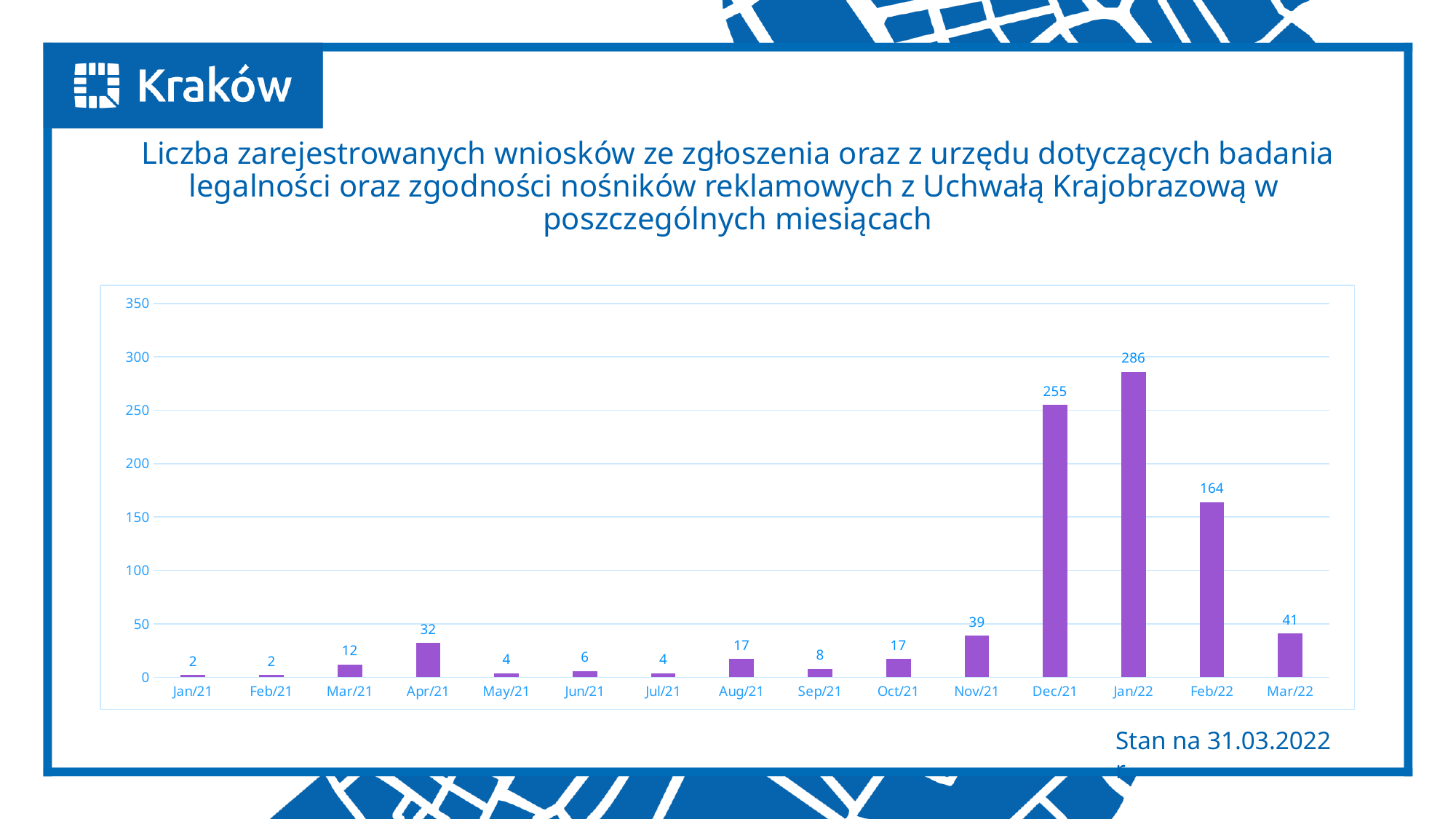
Which month has the highest value? Jan/22 What is the value for Sep/21? 8 How many months are shown on the x axis? 15 Is the value for Feb/22 greater or less than 150? greater Which is larger, the value for Nov/21 or the value for Mar/22? Mar/22 What is the value for Mar/22? 41 What is the difference between the values for Dec/21 and Nov/21? 216 What is the value for Dec/21? 255 What is the difference between the values for Jan/22 and Feb/22? 122 What kind of chart is shown on the slide? bar chart What colour are the bars in the chart? purple What is the value for Apr/21? 32